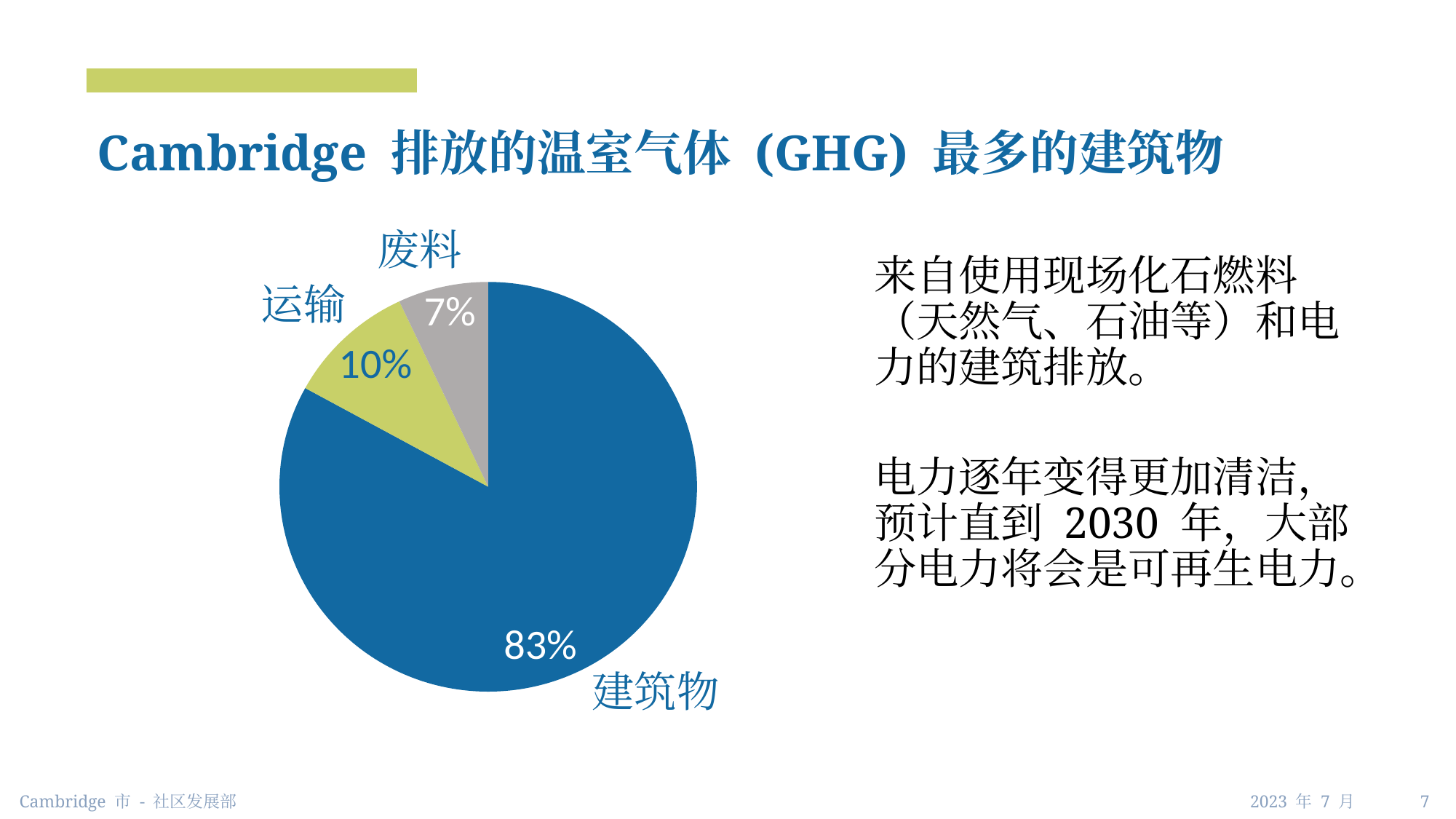
What share of the pie does 建筑物 (buildings) account for? 83% Which category has the smallest slice of the pie? 废料 What share of the pie does 运输 (transportation) account for? 10% What kind of chart is shown on the slide? Pie chart What colour is the slice for 废料? Grey Which category has the largest slice of the pie? 建筑物 What is the difference in percentage points between 运输 and 废料? 3 How many categories are shown in the pie chart? 3 What is the difference in percentage points between 建筑物 and 运输? 73 What share of the pie does 废料 (waste) account for? 7% What colour is the slice for 建筑物? Blue Which is larger, the share for 运输 or the share for 废料? 运输